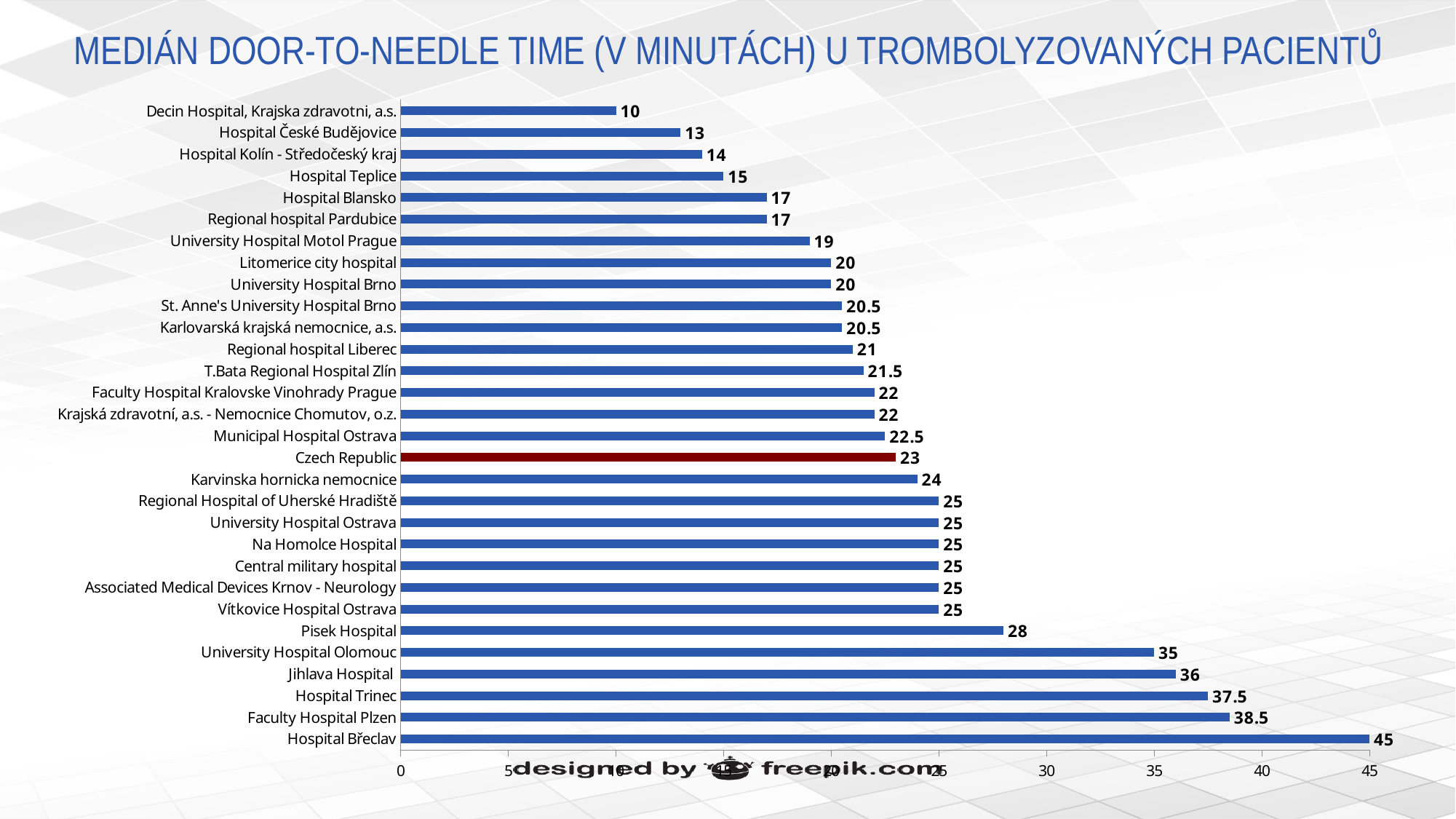
Which hospital has the highest median door-to-needle time? Hospital Břeclav What is the value shown for Czech Republic? 23 Which bar is shown in a different colour (dark red) from the others? Czech Republic What type of chart is shown on the slide? Bar chart What is the difference between the values for Faculty Hospital Plzen and Hospital Trinec? 1 What is the median door-to-needle time for Hospital Břeclav? 45 What is the value for Municipal Hospital Ostrava? 22.5 What is the median door-to-needle time for University Hospital Motol Prague? 19 How many categories (bars) are shown in the chart? 30 Which has a larger value, University Hospital Olomouc or Pisek Hospital? University Hospital Olomouc Which hospital has the lowest median door-to-needle time? Decin Hospital, Krajska zdravotni, a.s. What is the difference between Hospital Břeclav and the Czech Republic value? 22